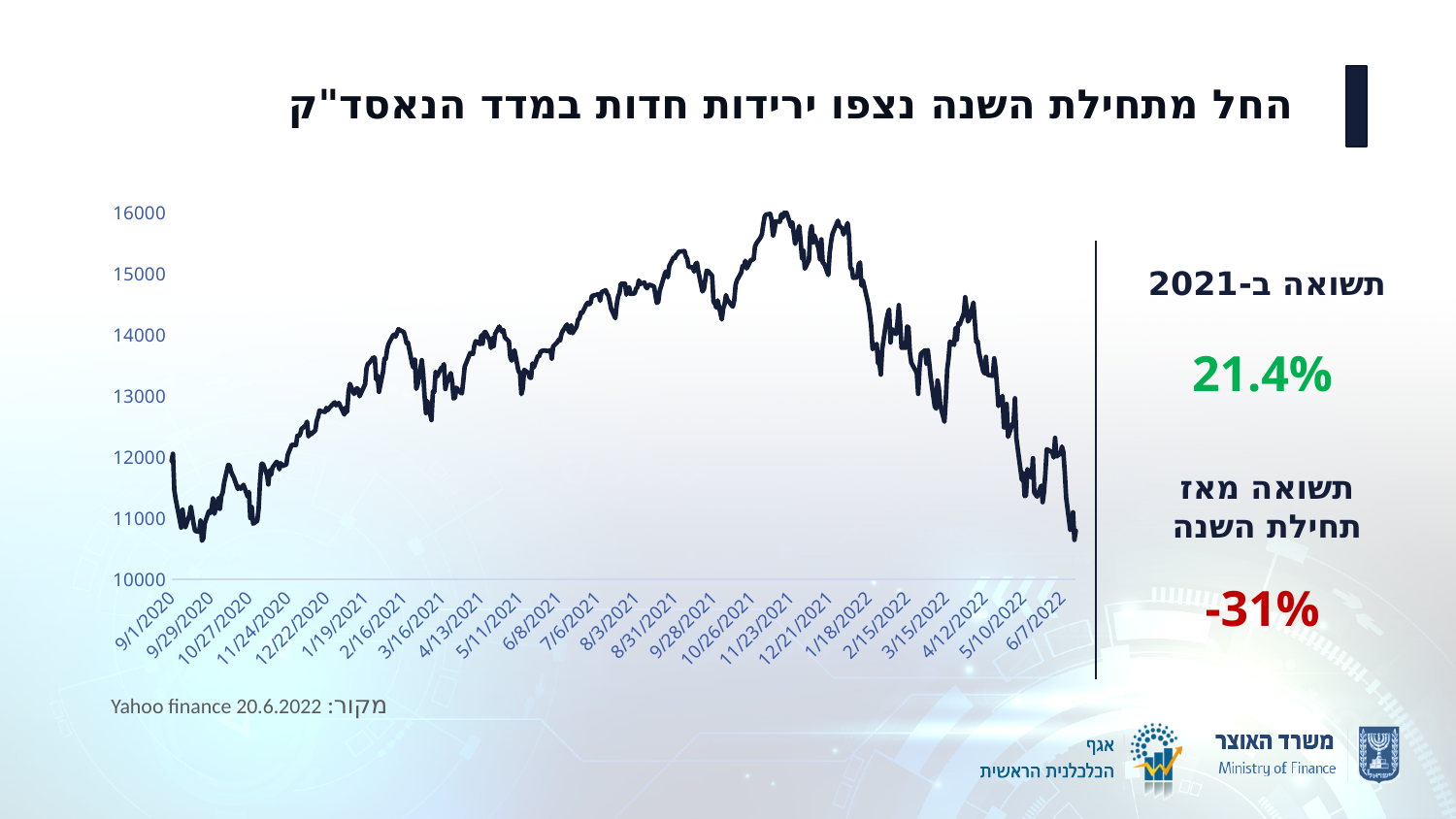
Around which x-axis date does the index reach its highest point? 11/23/2021 What return since the start of the year is printed next to the chart? -31% Is the value of the index at 6/7/2022 greater or less than 11000? greater What is the first date label on the x axis of the chart? 9/1/2020 What kind of chart is shown on the slide? line chart Is the value of the index at 9/1/2020 greater or less than 11000? greater Is the value of the index around 3/16/2021 greater or less than 12000? greater How many date labels are shown along the x axis of the chart? 24 Does the index generally rise or fall between 9/1/2020 and 11/23/2021? rise What is the last date label on the x axis of the chart? 6/7/2022 Does the index generally rise or fall between 11/23/2021 and 6/7/2022? fall